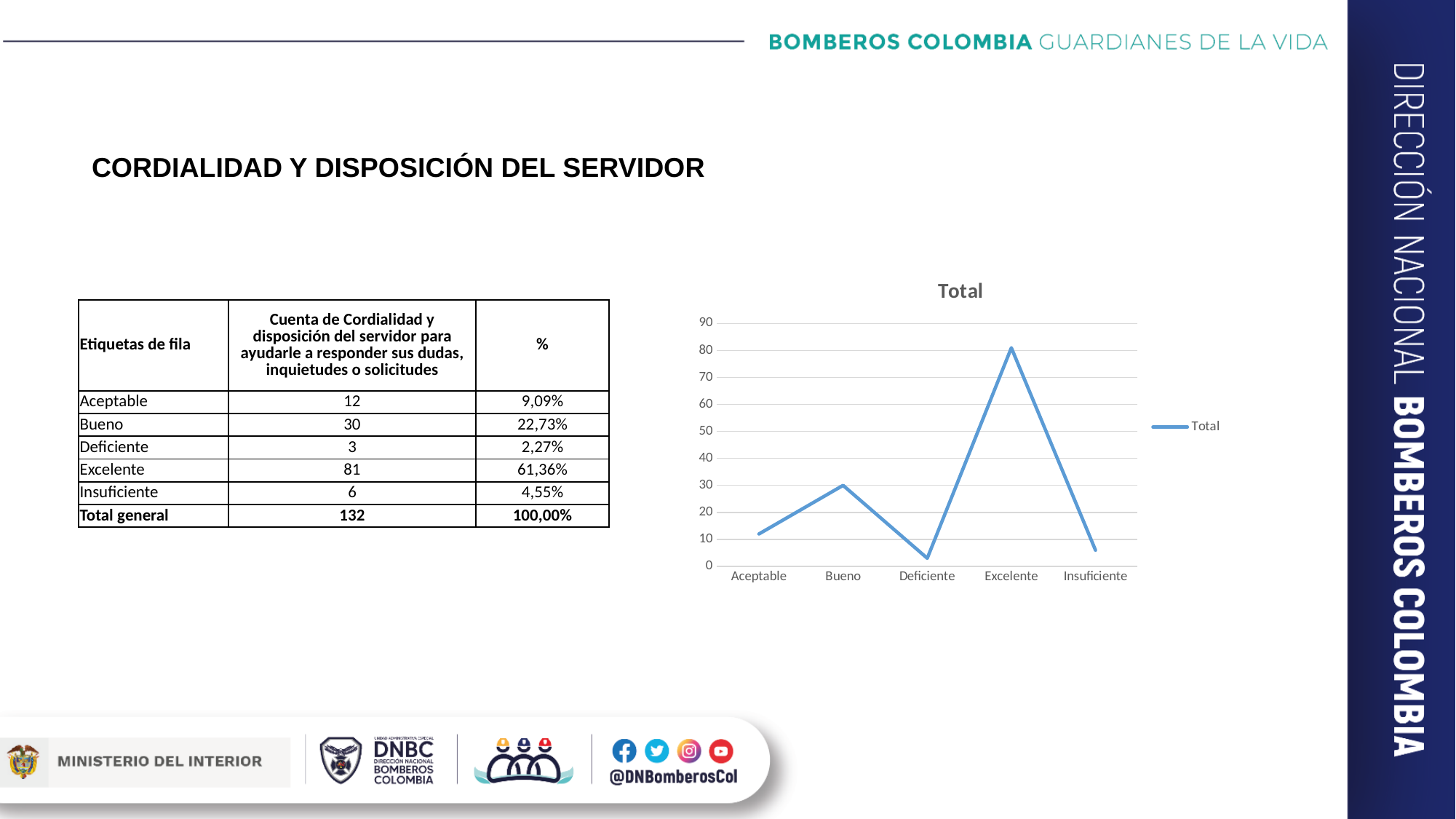
Which category has the highest value in the chart? Excelente Is the value for Insuficiente greater or less than 10? less Is the value for Excelente greater or less than 80? greater What kind of chart is shown on the slide? line chart What is the title of the chart? Total How many series does the chart legend list? 1 What is the value for Excelente in the chart? 81 Which category has the lowest value in the chart? Deficiente How many categories are shown on the x axis of the chart? 5 What is the difference between the values for Excelente and Bueno? 51 What is the value for Bueno in the chart? 30 Which is larger in the chart, the value for Aceptable or the value for Bueno? Bueno